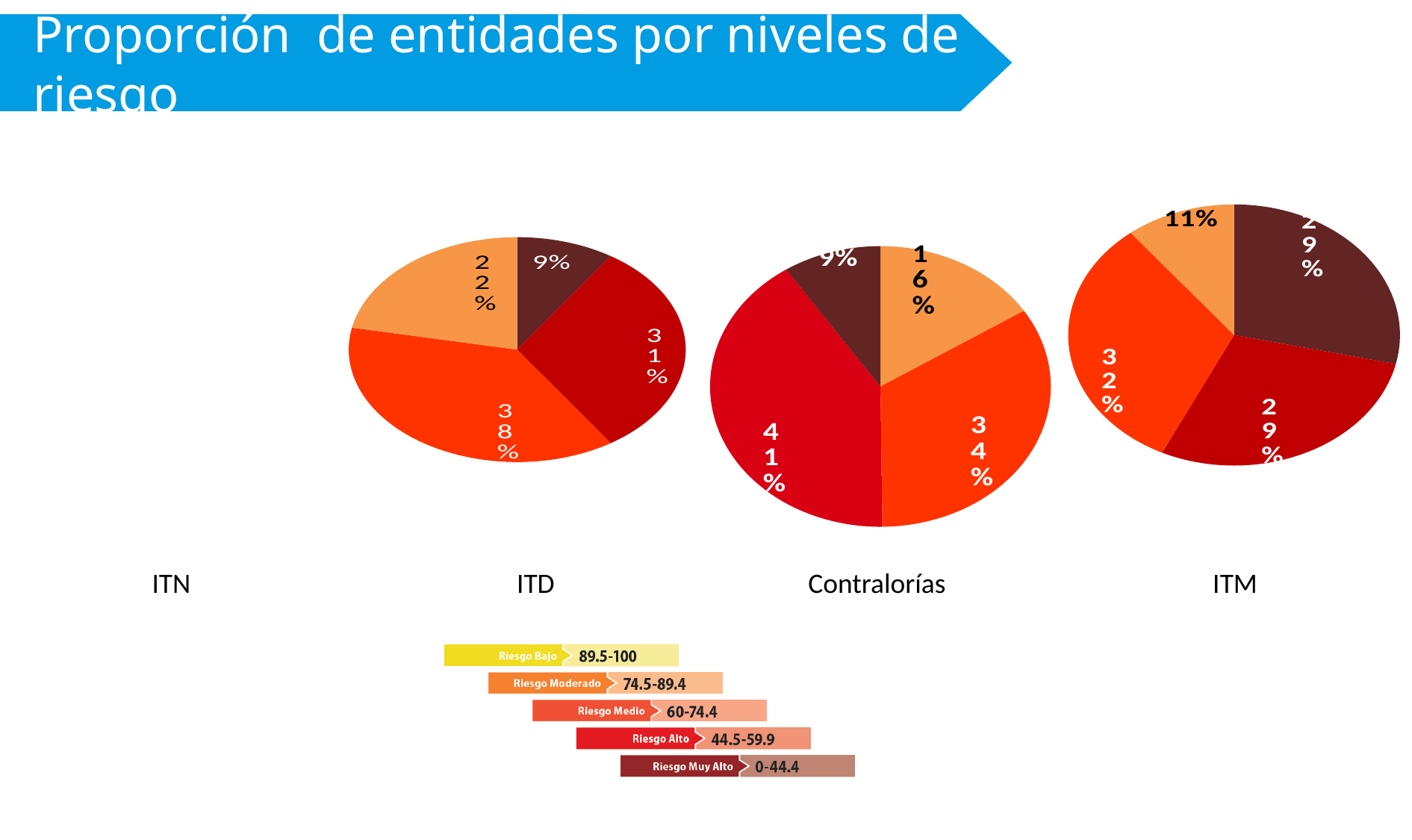
In the ITM pie chart, what is the value of the smallest slice? 11% Which is larger: the dark maroon slice in the ITD pie chart or the dark maroon slice in the ITM pie chart? ITM In the Contralorías pie chart, what is the value of the light orange slice? 16% In the ITD pie chart, what is the value of the smallest slice? 9% How many slices does the ITD pie chart have? 4 In the Contralorías pie chart, what is the value of the largest slice? 41% What kind of chart is used for ITD, Contralorías and ITM? Pie chart According to the legend, what score range corresponds to Riesgo Muy Alto? 0-44.4 In the ITD pie chart, what is the value of the largest slice? 38% In the Contralorías pie chart, what is the difference between the 41% slice and the 34% slice? 7 percentage points How many risk levels does the legend at the bottom of the slide list? 5 In the ITM pie chart, what is the value of the dark maroon slice? 29%